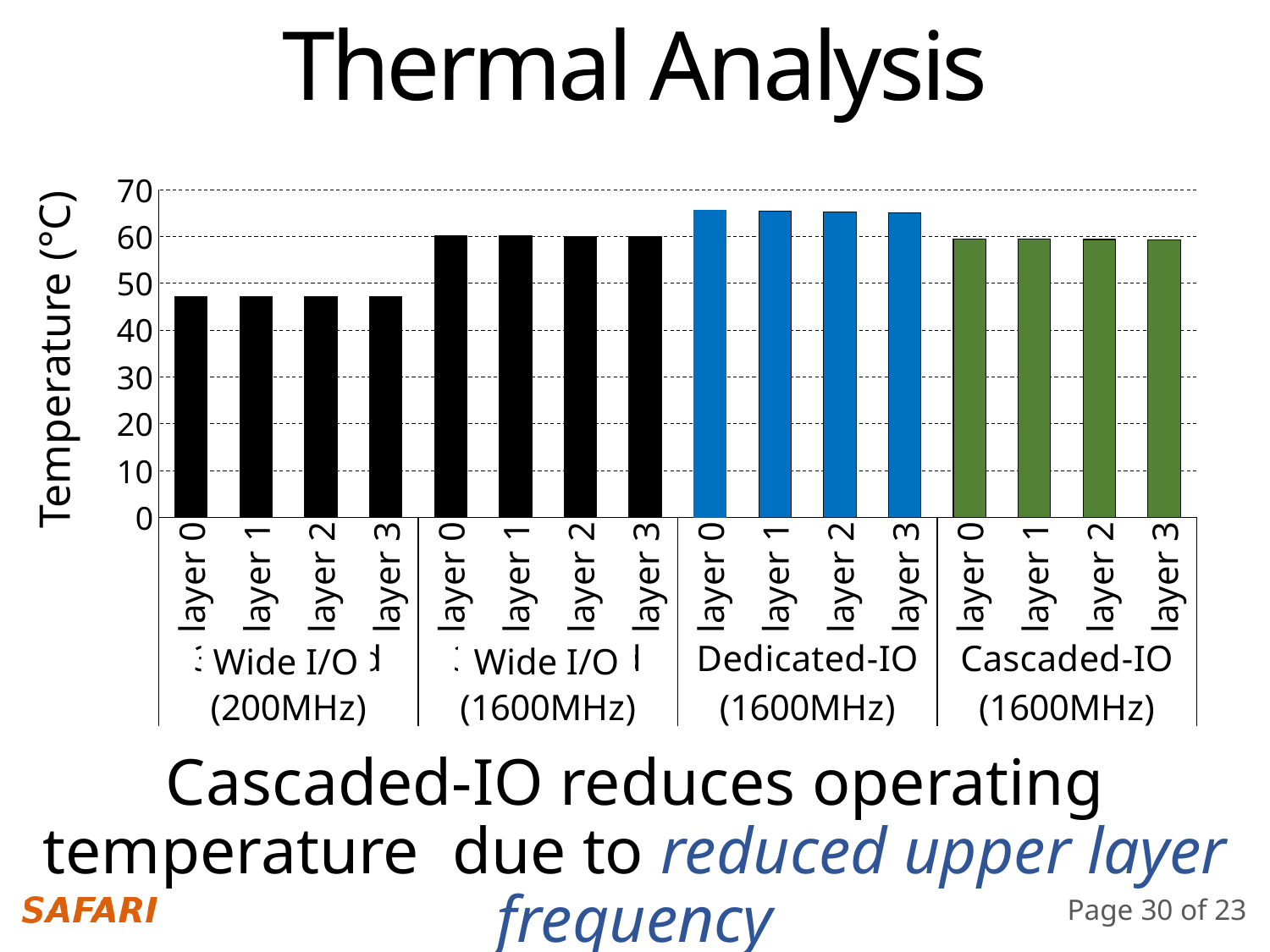
What type of chart is shown on the slide? bar chart Is the temperature for Dedicated-IO (1600MHz) layer 0 greater or less than 60? greater Is the temperature for Cascaded-IO (1600MHz) layer 3 greater or less than 50? greater Which configuration group has the highest temperatures? Dedicated-IO (1600MHz) Which configuration group has the lowest temperatures? Wide I/O (200MHz) Which is higher, the temperature for Dedicated-IO (1600MHz) layer 0 or Cascaded-IO (1600MHz) layer 0? Dedicated-IO (1600MHz) layer 0 Is the temperature for Wide I/O (200MHz) layer 0 greater or less than 50? less How many bars are plotted in the chart? 16 How many configuration groups are shown along the x axis? 4 Which is higher, the temperature for Wide I/O (200MHz) layer 1 or Wide I/O (1600MHz) layer 1? Wide I/O (1600MHz) layer 1 What is the label of the y axis? Temperature (°C)